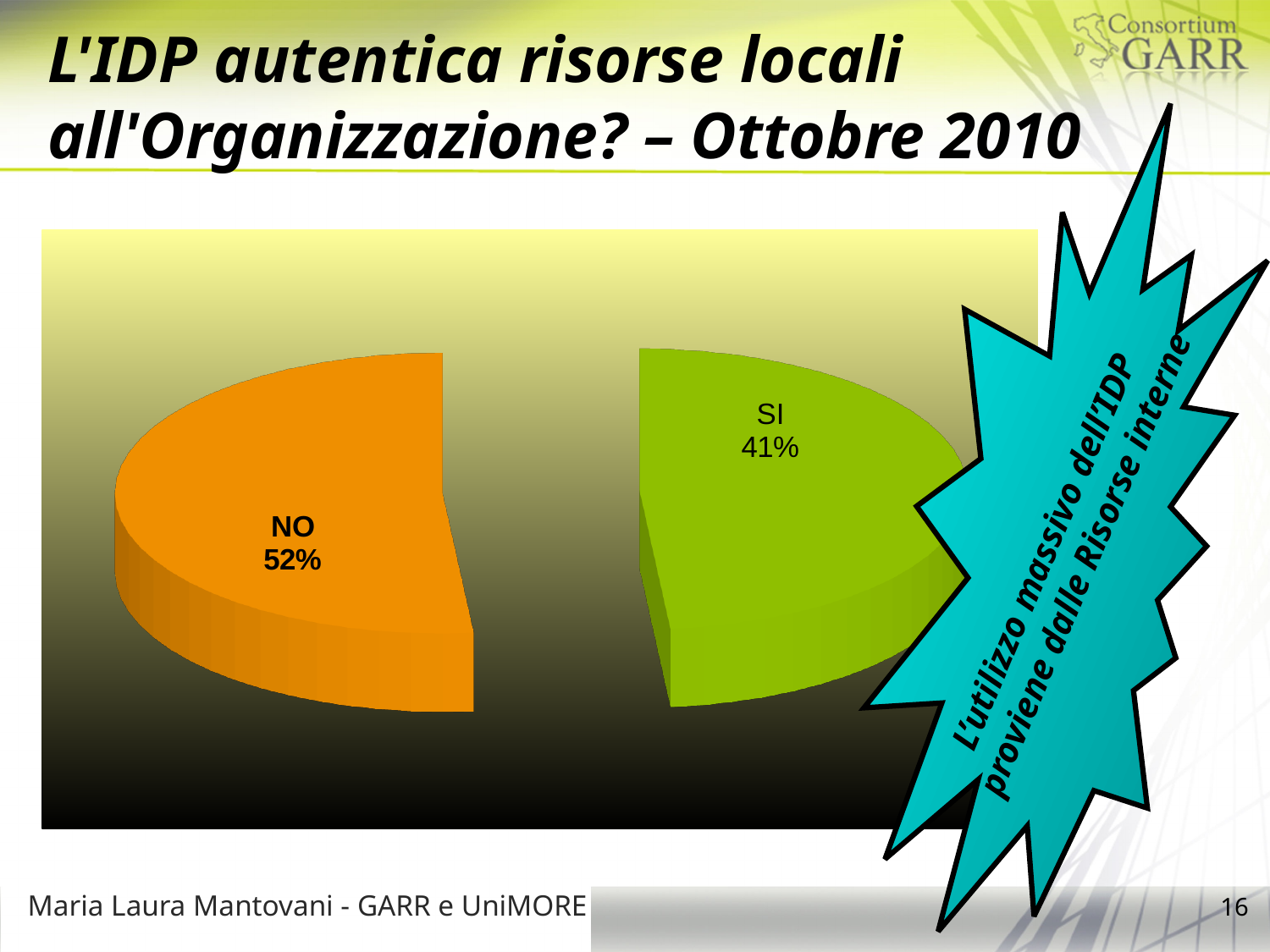
What colour is the SI slice of the pie chart? Green Is the share for NO greater or less than 50%? greater Is the share for SI greater or less than 50%? less Which slice is larger, NO or SI? NO What percentage is shown for the NO slice of the pie chart? 52% By how many percentage points does the NO slice exceed the SI slice? 11 percentage points Which labelled slice of the pie chart has the largest share? NO What percentage is shown for the SI slice of the pie chart? 41% What colour is the NO slice of the pie chart? Orange What kind of chart is shown on the slide? Pie chart